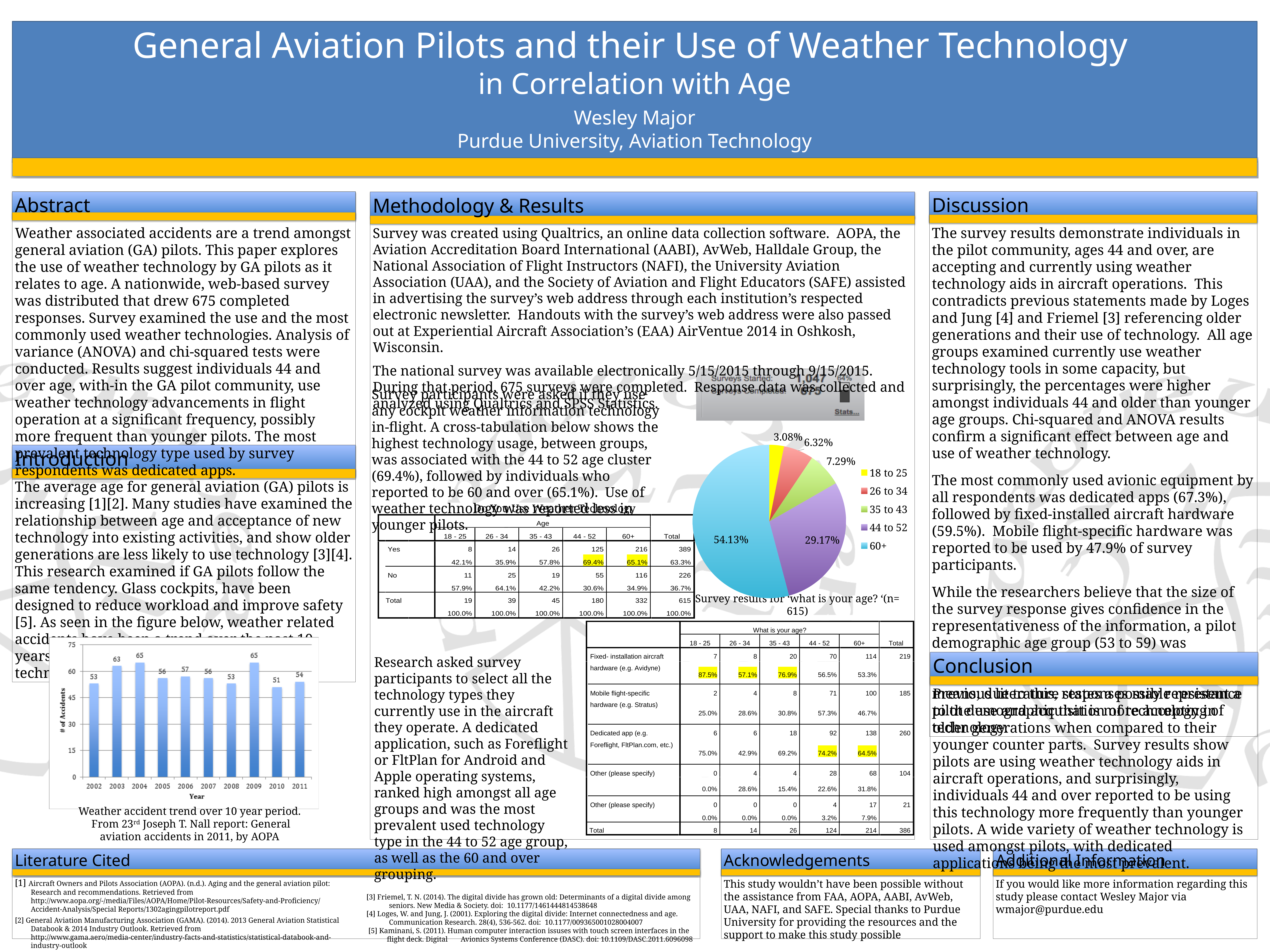
In the bar chart of weather accidents over a 10 year period, how many years are shown on the x axis? 10 In the bar chart of weather accidents over a 10 year period, which year had more accidents, 2006 or 2008? 2006 What kind of chart is the weather accident trend chart? bar chart In the pie chart of survey results for 'what is your age?', which age group has the largest slice? 60+ In the bar chart of weather accidents over a 10 year period, how many accidents were recorded in 2010? 51 In the bar chart of weather accidents over a 10 year period, which year has the lowest number of accidents? 2010 How many age groups does the legend of the pie chart list? 5 In the bar chart of weather accidents over a 10 year period, how many accidents were recorded in 2004? 65 In the bar chart of weather accidents over a 10 year period, what is the difference between the number of accidents in 2003 and in 2002? 10 In the pie chart of survey results for 'what is your age?', what share of respondents are 60+? 54.13% In the pie chart of survey results for 'what is your age?', what share of respondents are 18 to 25? 3.08% In the bar chart of weather accidents over a 10 year period, what is the label of the y axis? # of Accidents